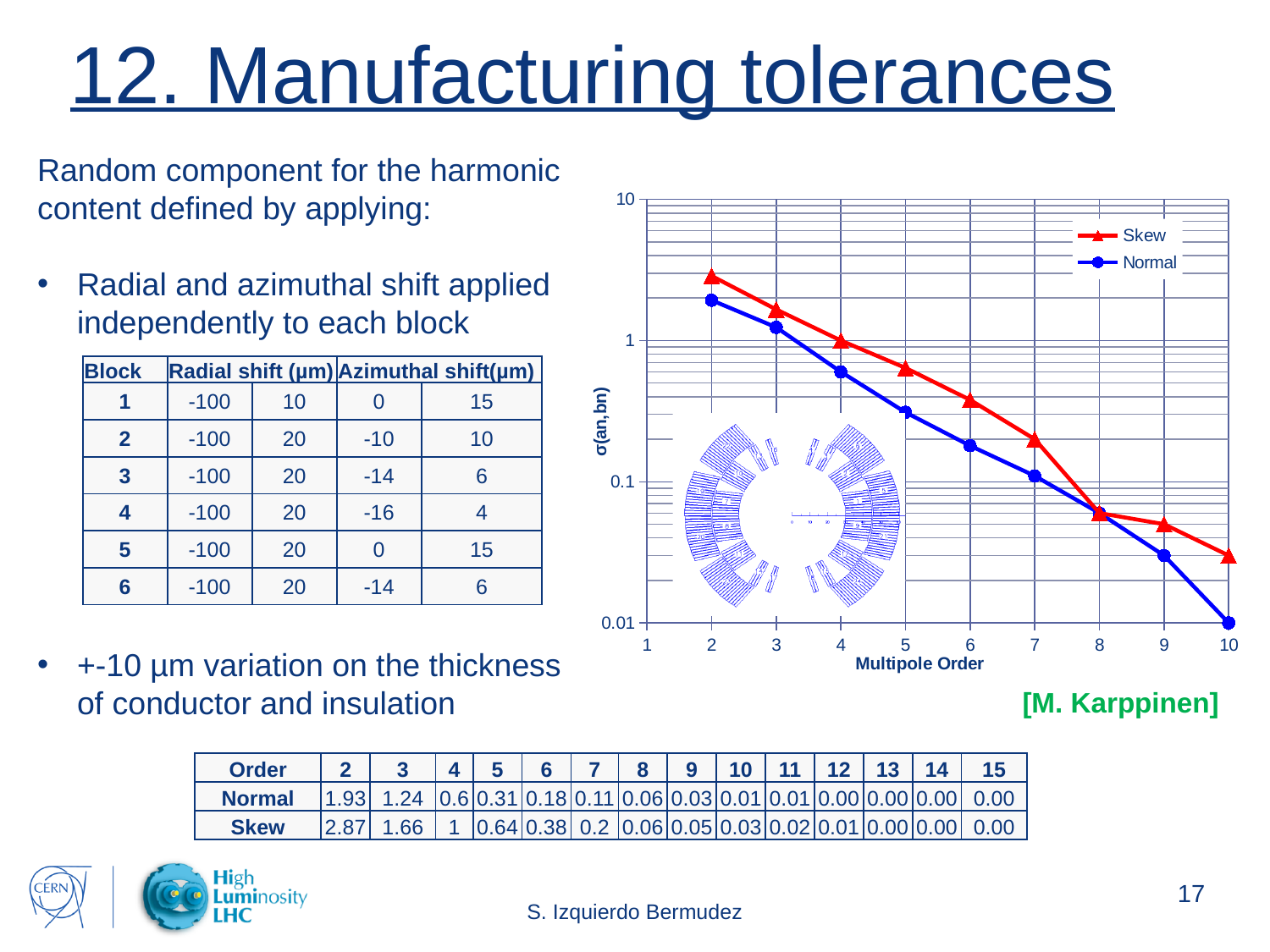
What is the difference between the Skew and Normal values at multipole order 3? 0.42 What are the two series named in the chart legend? Skew and Normal What kind of chart is shown on the slide? line chart At which multipole order is the Skew series highest? 2 Do the plotted values rise or fall as the multipole order increases? fall What is the Normal value at multipole order 2? 1.93 How many series does the chart legend list? 2 What is the title of the x axis of the chart? Multipole Order At multipole order 4, which series has the larger value, Skew or Normal? Skew What is the Skew value at multipole order 5? 0.64 What is the Skew value at multipole order 2? 2.87 Is the Normal value at multipole order 5 greater or less than 0.1? greater